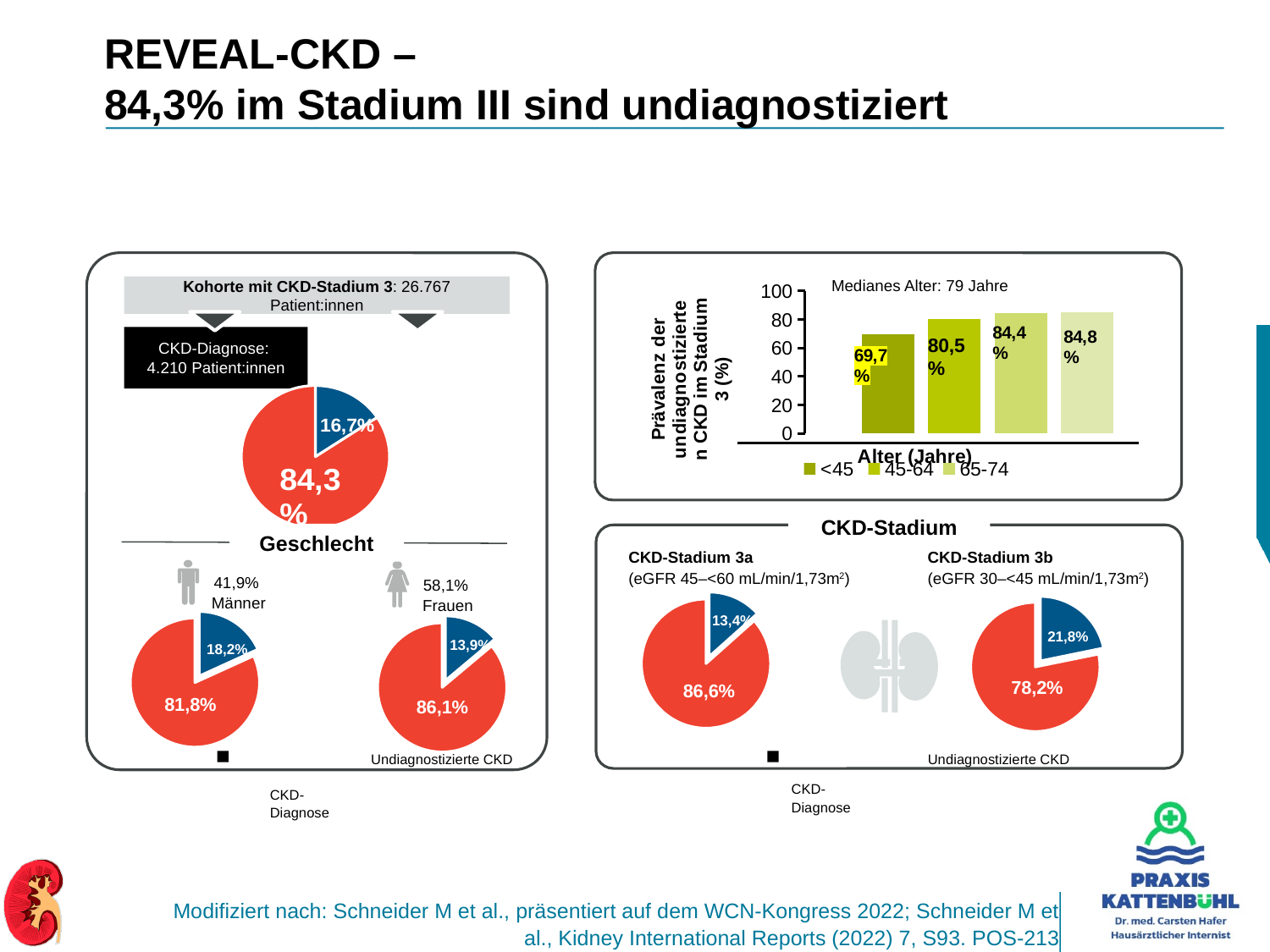
In the bar chart by age (top right), what is the value for the 45-64 age group? 80,5% In the bar chart by age (top right), what is the difference between the values for the 45-64 and <45 age groups? 10,8% In the bar chart by age (top right), do the values rise or fall as age increases along the x axis? rise In the pie chart for CKD-Stadium 3b (bottom right), what share has a CKD diagnosis? 21,8% In the bar chart of prevalence of undiagnosed CKD by age (top right), what is the value for the <45 age group? 69,7% In the pie chart for Männer (left panel), what share has a CKD diagnosis? 18,2% Comparing the pie charts for CKD-Stadium 3a and CKD-Stadium 3b (bottom right), which stage has the larger share of undiagnosed CKD? CKD-Stadium 3a In the bar chart by age (top right), how many bars are plotted? 4 In the bar chart by age (top right), which of the labelled age groups has the lowest prevalence of undiagnosed CKD? <45 In the large pie chart on the left for the whole CKD stage 3 cohort, what share is undiagnosed CKD? 84,3% In the pie chart for Frauen (left panel), what share is undiagnosed CKD? 86,1% In the bar chart by age (top right), what is the value for the 65-74 age group? 84,4%